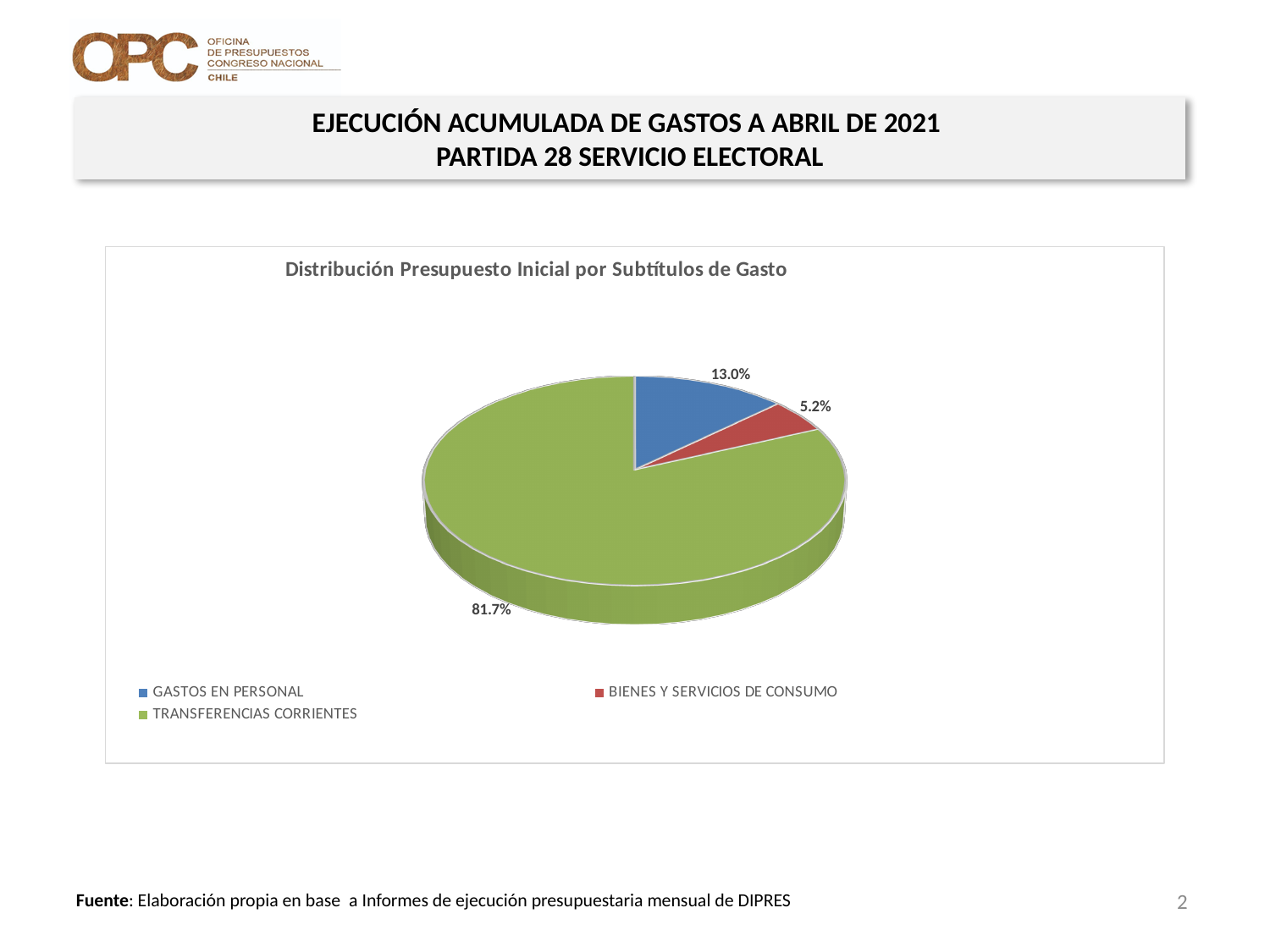
What kind of chart is shown on the slide? Pie chart What is the difference in percentage points between GASTOS EN PERSONAL and BIENES Y SERVICIOS DE CONSUMO? 7.8 percentage points What share of the pie does TRANSFERENCIAS CORRIENTES represent? 81.7% How many categories does the pie chart show? 3 What share of the pie does BIENES Y SERVICIOS DE CONSUMO represent? 5.2% What is the title of the chart? Distribución Presupuesto Inicial por Subtítulos de Gasto What share of the pie does GASTOS EN PERSONAL represent? 13.0% Which is larger, the share for GASTOS EN PERSONAL or the share for BIENES Y SERVICIOS DE CONSUMO? GASTOS EN PERSONAL Which category has the largest slice of the pie? TRANSFERENCIAS CORRIENTES Which category has the smallest slice of the pie? BIENES Y SERVICIOS DE CONSUMO What is the difference in percentage points between TRANSFERENCIAS CORRIENTES and GASTOS EN PERSONAL? 68.7 percentage points What colour is the slice for TRANSFERENCIAS CORRIENTES? Green